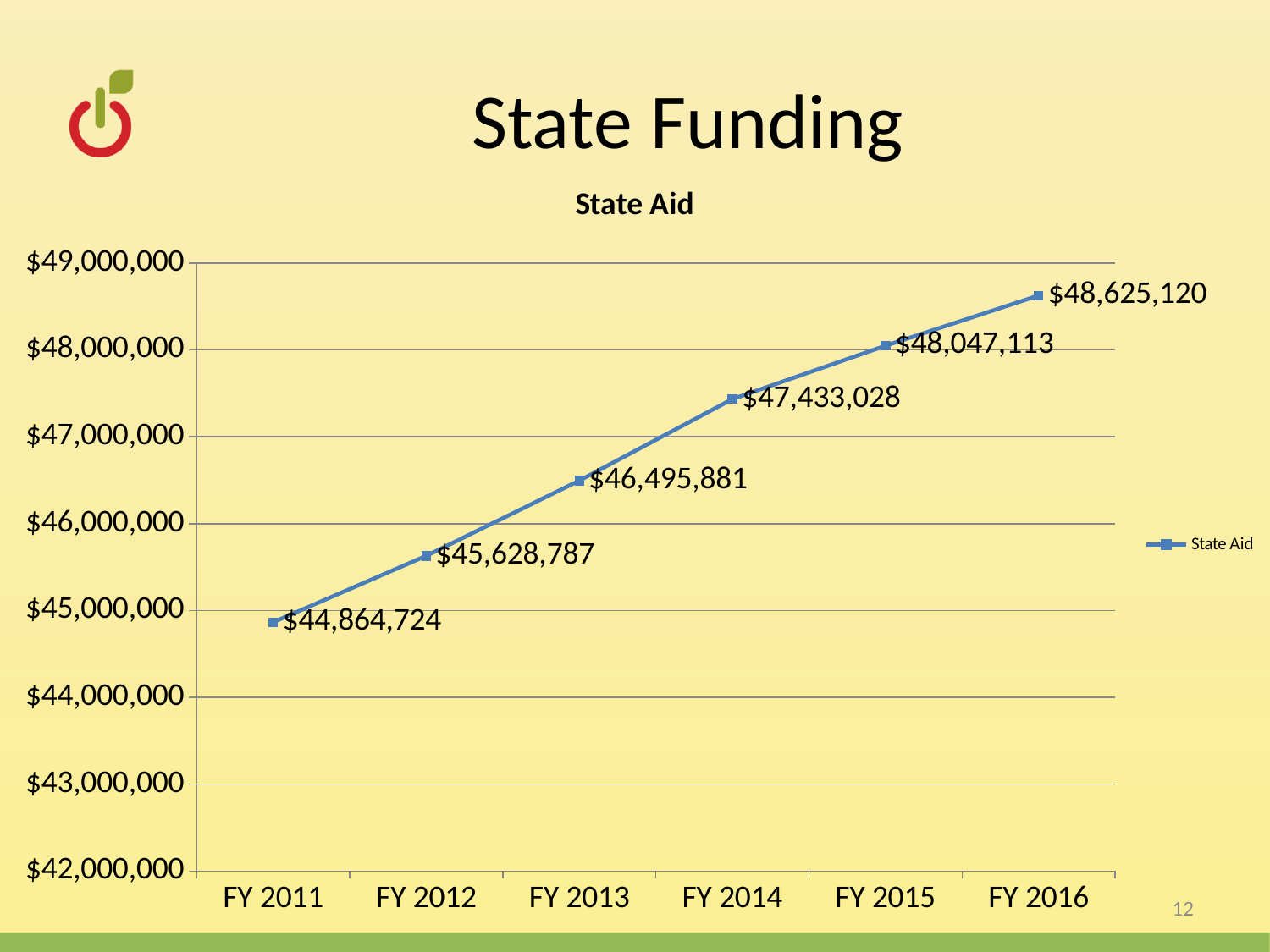
Does State Aid rise or fall from FY 2011 to FY 2016? rise What is the State Aid value for FY 2015? $48,047,113 Which is larger, the State Aid value for FY 2014 or for FY 2012? FY 2014 Which fiscal year has the lowest State Aid value? FY 2011 Which fiscal year has the highest State Aid value? FY 2016 Is the State Aid value for FY 2014 greater or less than $47,000,000? greater What is the State Aid value for FY 2013? $46,495,881 What is the difference in State Aid between FY 2016 and FY 2011? $3,760,396 What is the difference in State Aid between FY 2013 and FY 2012? $867,094 How many fiscal years are plotted on the chart? 6 What is the State Aid value for FY 2011? $44,864,724 What kind of chart is shown on the slide? line chart